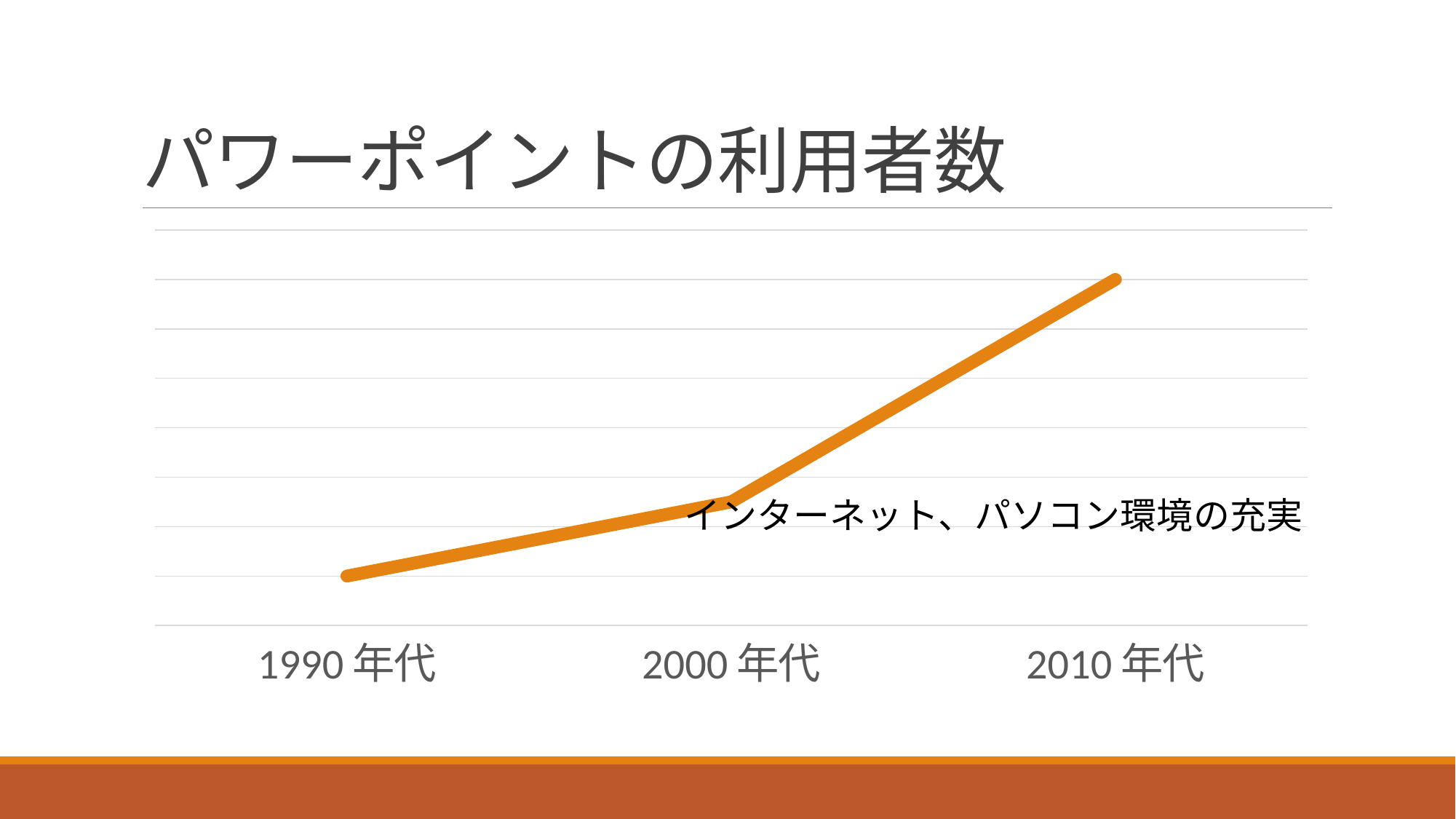
How many categories are plotted along the x axis? 3 What is the label of the last category on the x axis? 2010年代 Which category has the highest value? 2010年代 Which category has the lowest value? 1990年代 What is the title of the slide? パワーポイントの利用者数 What text annotation is placed next to the line near 2000年代? インターネット、パソコン環境の充実 What kind of chart is shown on the slide? line chart What is the label of the first category on the x axis? 1990年代 Which is larger, the value for 2000年代 or the value for 2010年代? 2010年代 Which is larger, the value for 1990年代 or the value for 2000年代? 2000年代 Do the values rise or fall from 1990年代 to 2010年代? rise